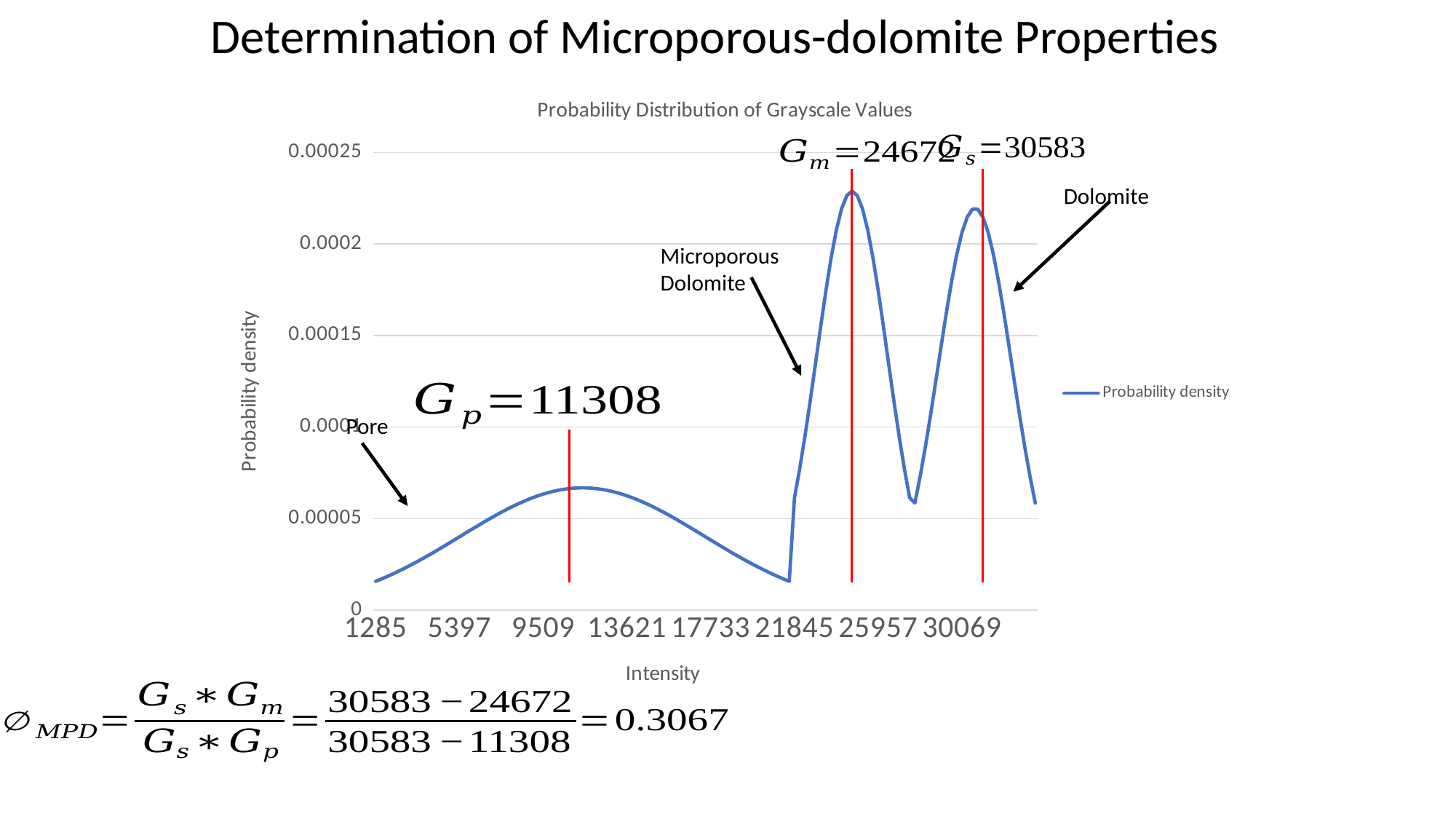
What type of chart is shown on the slide? line chart What is the label of the x axis? Intensity How many series does the chart legend list? 1 What intensity value is given for G_m on the chart? 24672 Is the peak probability density of the Pore region greater or less than 0.0001? less Which labeled region has the lowest peak probability density: Pore, Microporous Dolomite, or Dolomite? Pore Is the probability density at intensity 1285 greater or less than 0.00005? less What intensity value is given for G_s on the chart? 30583 What intensity value is given for G_p on the chart? 11308 Which peak is higher, the Pore peak or the Dolomite peak? Dolomite What is the title of the chart? Probability Distribution of Grayscale Values Is the peak probability density of the Microporous Dolomite region greater or less than 0.0002? greater